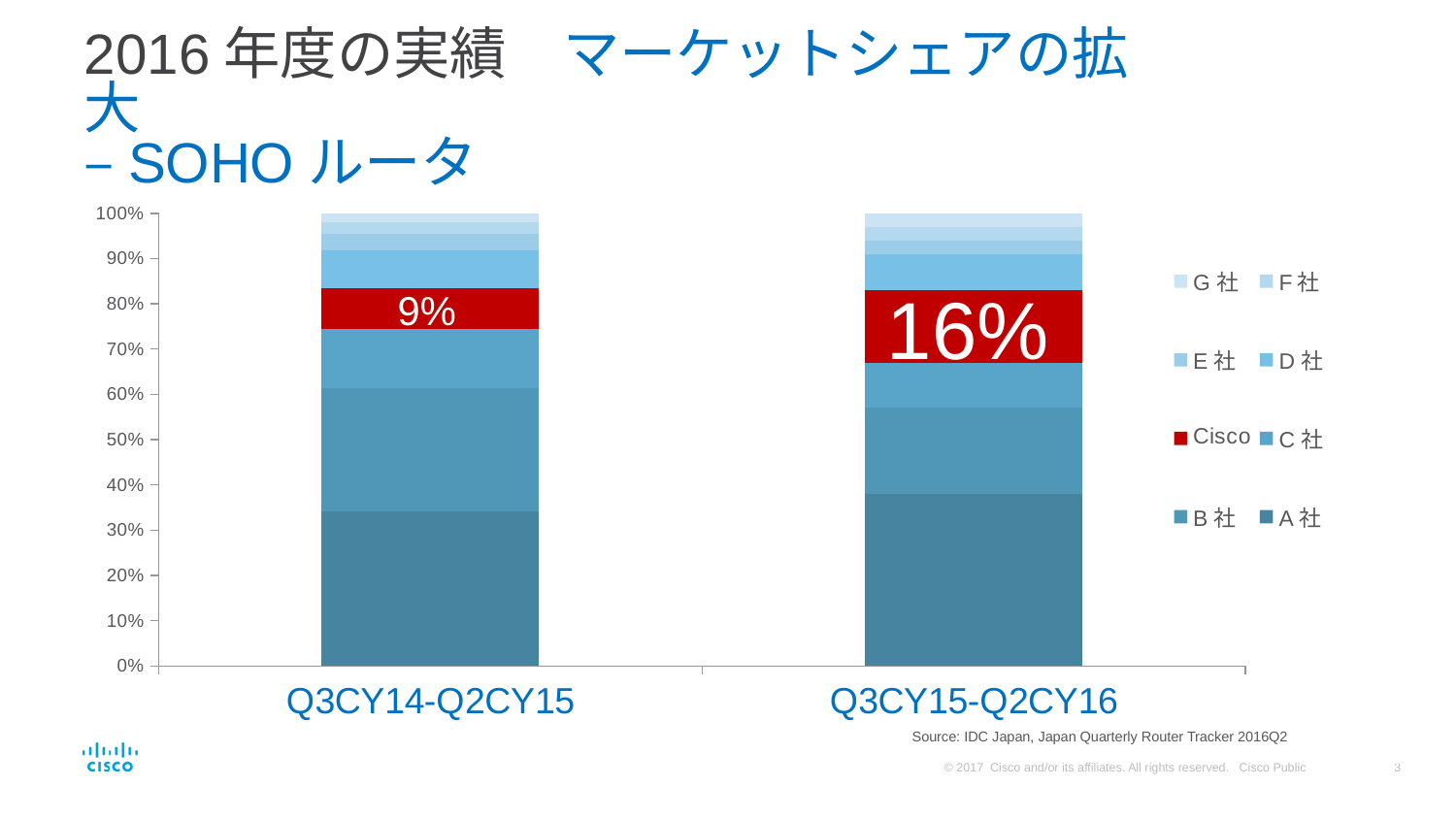
Is the value for A社 in Q3CY14-Q2CY15 greater or less than 30%? greater What does each stacked bar total? 100% What colour represents Cisco in the chart? red Which company has the largest share in Q3CY14-Q2CY15? A社 How many periods (categories) are shown on the x axis? 2 In which period is Cisco's share larger, Q3CY14-Q2CY15 or Q3CY15-Q2CY16? Q3CY15-Q2CY16 What is Cisco's market share for Q3CY14-Q2CY15? 9% What is Cisco's market share for Q3CY15-Q2CY16? 16% What kind of chart is shown on the slide? stacked bar chart Does Cisco's share rise or fall from Q3CY14-Q2CY15 to Q3CY15-Q2CY16? rise By how many percentage points did Cisco's share change from Q3CY14-Q2CY15 to Q3CY15-Q2CY16? 7% How many series does the legend list? 8